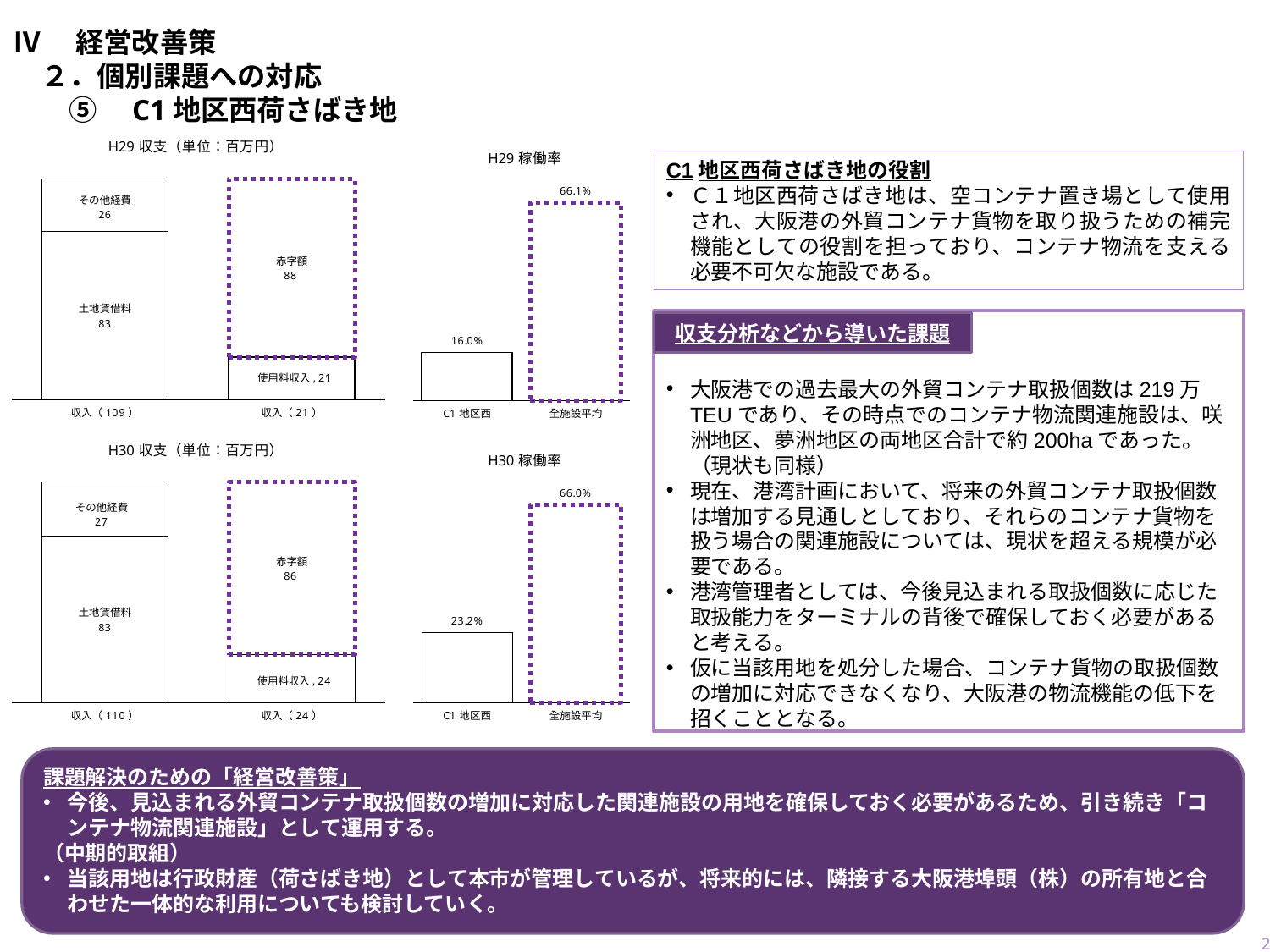
In the H29 収支 chart, what is the difference between 赤字額 and 使用料収入? 67 In the H30 稼働率 chart, what is the difference between 全施設平均 and C1 地区西? 42.8 percentage points In the H30 稼働率 chart, what is the value for C1 地区西? 23.2% In the H30 稼働率 chart, which category is higher, C1 地区西 or 全施設平均? 全施設平均 What kind of chart is the H29 稼働率 chart? Bar chart In the H30 収支 chart, what is the value of 使用料収入? 24 In the H30 収支 chart, what is the total of the left stacked bar (その他経費 plus 土地賃借料)? 110 In the H29 収支 chart, what is the value of 赤字額? 88 In the H30 収支 chart, what is the value of その他経費? 27 In the H29 稼働率 chart, what is the value for C1 地区西? 16.0% In the H29 稼働率 chart, what is the value for 全施設平均? 66.1% In the H29 収支 chart, what is the value of 土地賃借料? 83